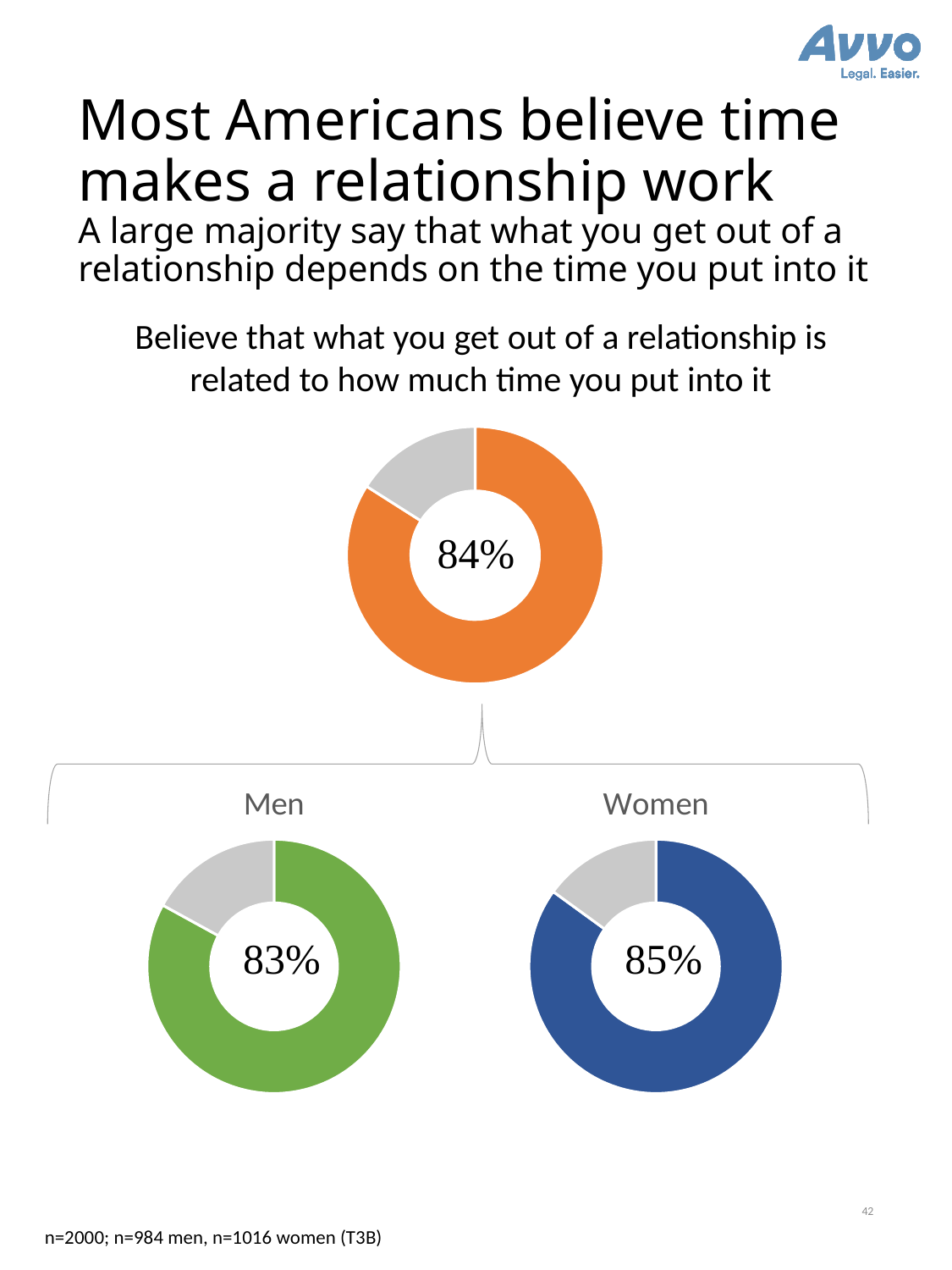
What kind of chart is used to display the percentages on this slide? Doughnut chart What colour is the main segment of the Women doughnut chart? Blue What percentage is shown in the centre of the top (overall) doughnut chart? 84% In the Men doughnut chart, what percentage believe that what you get out of a relationship is related to how much time you put into it? 83% What is the difference in percentage points between the overall value (top chart) and the Men value? 1 percentage point In the Women doughnut chart, what percentage is shown? 85% In the Men doughnut chart, what share of the ring is the grey (remaining) portion? 17% Which group shows the higher percentage, Men or Women? Women What is the difference in percentage points between the Women value and the Men value? 2 percentage points Of the three doughnut charts on the slide, which one shows the lowest percentage? Men How many doughnut charts are shown on the slide? 3 Of the three doughnut charts on the slide, which one shows the highest percentage? Women